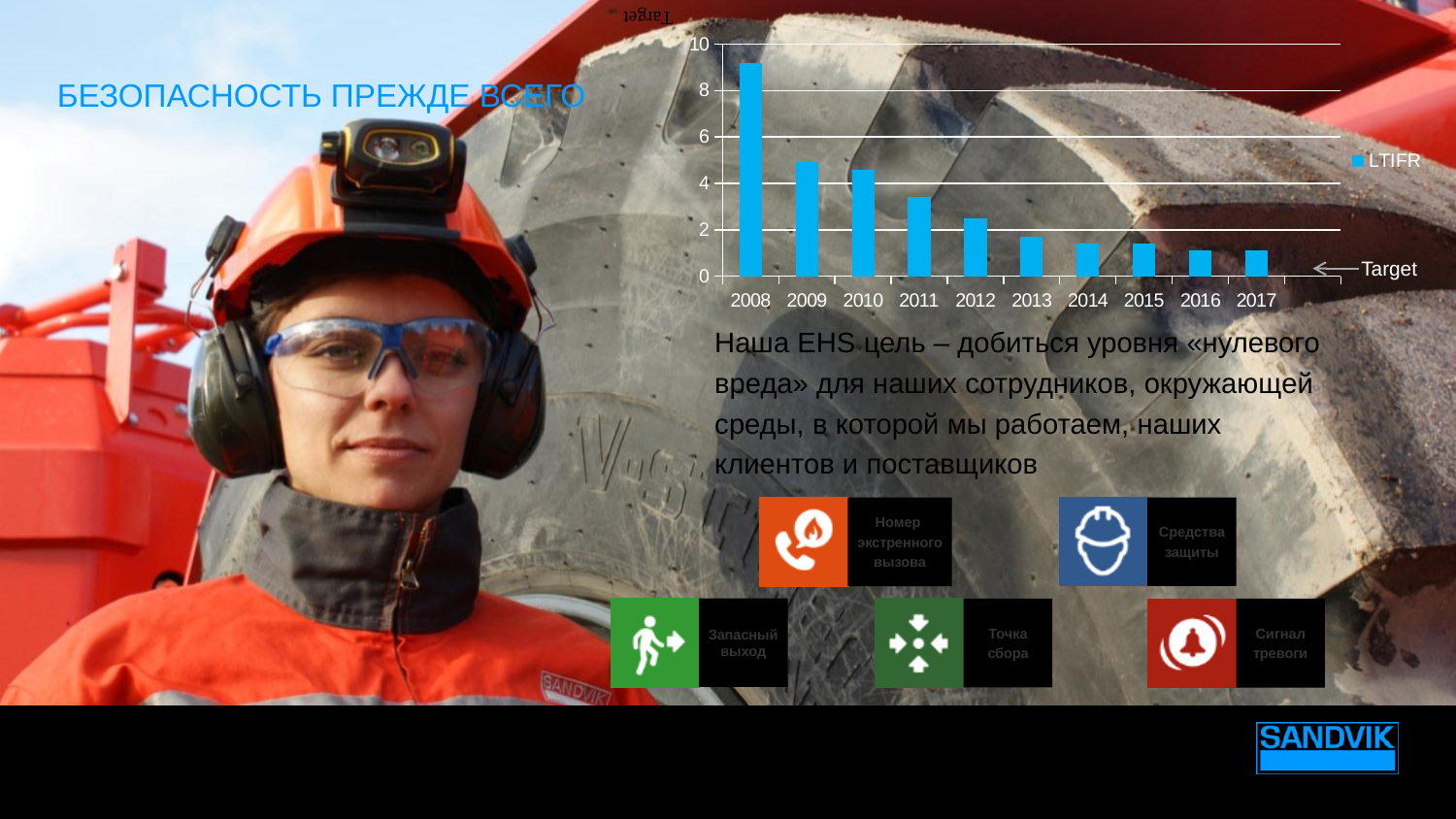
Is the LTIFR value for 2011 greater or less than 2? greater Is the LTIFR value for 2013 greater or less than 2? less Do the LTIFR values rise or fall from 2008 to 2017? fall What kind of chart is shown on the slide? bar chart Is the LTIFR value for 2008 greater or less than 8? greater How many years are shown on the x axis of the chart? 10 How many series does the chart legend list? 1 Which year has the highest LTIFR value? 2008 What series name is shown in the chart legend? LTIFR Which year has the larger LTIFR value, 2009 or 2011? 2009 What label is pointed to by the arrow at the right end of the chart's baseline? Target